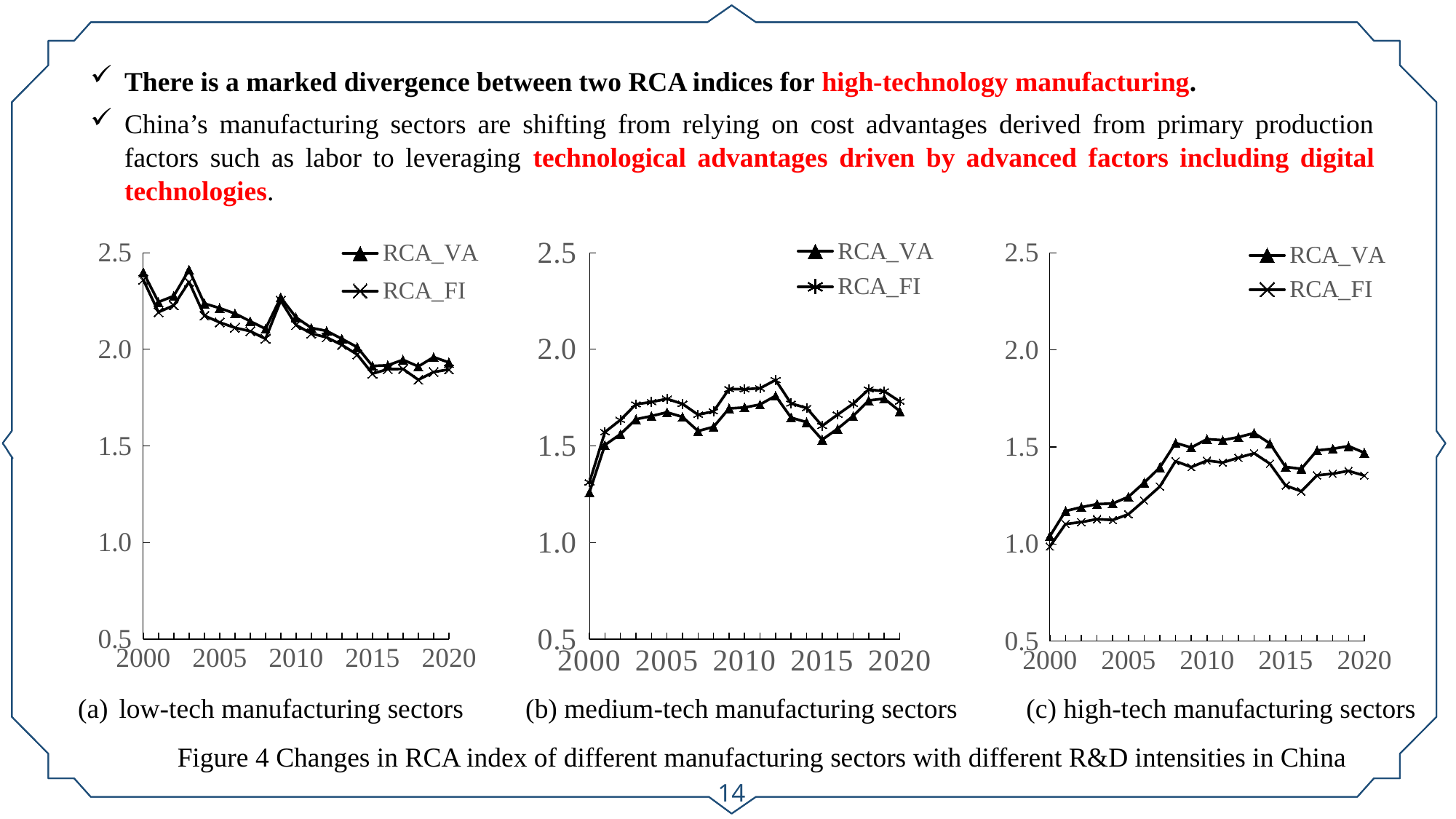
What are the two legend entries shown in chart (b) medium-tech manufacturing sectors? RCA_VA and RCA_FI In chart (b) medium-tech manufacturing sectors, is the RCA_VA value for 2000 greater or less than 1.5? less What kind of chart is chart (a) low-tech manufacturing sectors? line chart In chart (a) low-tech manufacturing sectors, is the RCA_FI value for 2020 greater or less than 2.0? less In chart (c) high-tech manufacturing sectors, is the RCA_FI value for 2020 greater or less than 1.5? less In chart (a) low-tech manufacturing sectors, do the RCA_VA values generally rise or fall from 2000 to 2020? fall How many series does the legend list in chart (c) high-tech manufacturing sectors? 2 In chart (c) high-tech manufacturing sectors, which series has the higher value in 2020, RCA_VA or RCA_FI? RCA_VA In chart (b) medium-tech manufacturing sectors, do the RCA_FI values generally rise or fall from 2000 to 2020? rise In chart (b) medium-tech manufacturing sectors, which series has the higher value in 2012, RCA_VA or RCA_FI? RCA_FI In chart (c) high-tech manufacturing sectors, do the RCA_VA values generally rise or fall from 2000 to 2020? rise